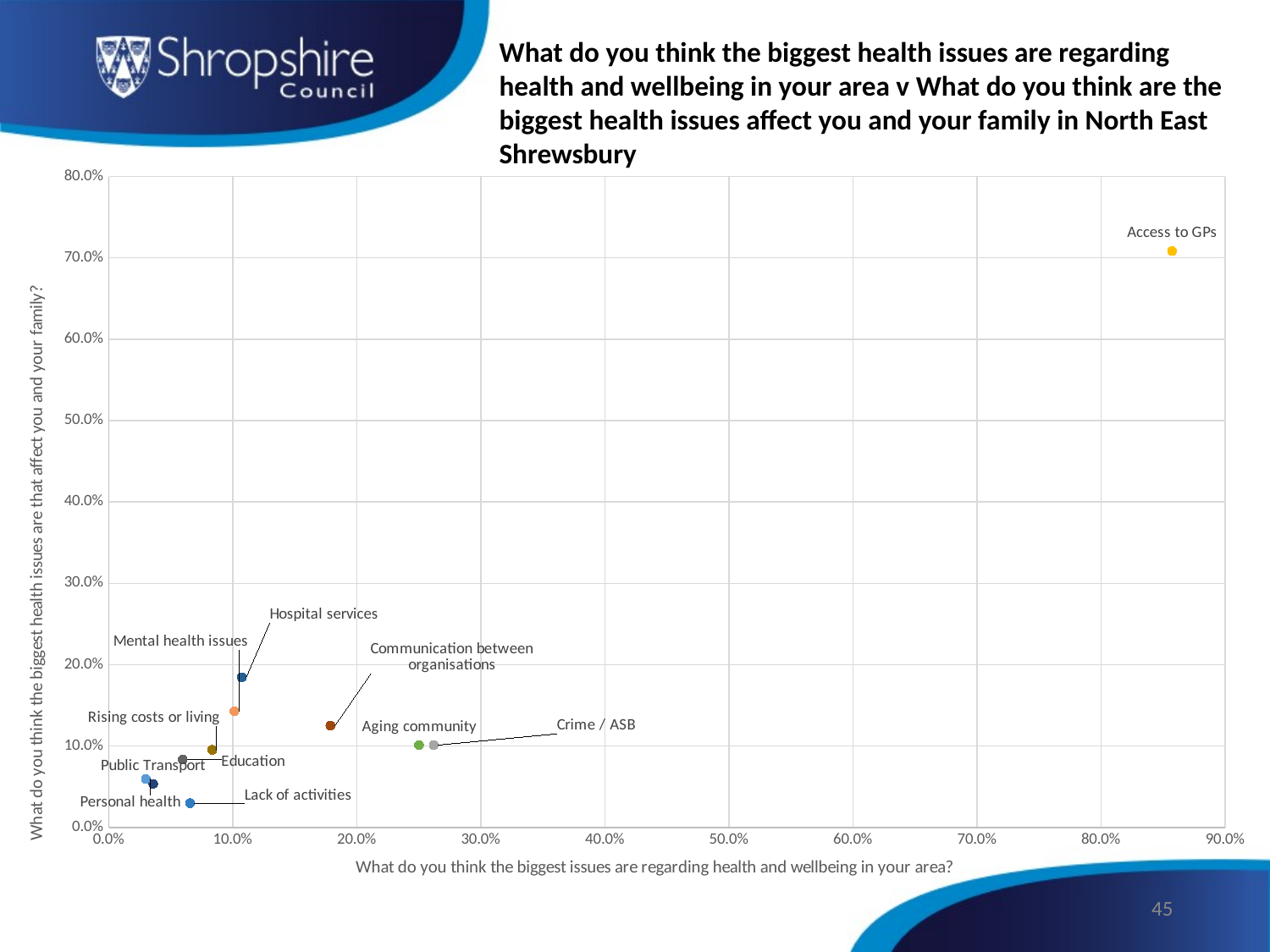
Is the horizontal-axis value for Access to GPs greater or less than 80%? greater What is the title of the horizontal axis? What do you think the biggest issues are regarding health and wellbeing in your area? What kind of chart is shown on the slide? scatter chart Which labelled point has the lowest value on the vertical axis? Personal health Is the horizontal-axis value for Aging community greater or less than 20%? greater Is the vertical-axis value for Access to GPs greater or less than 60%? greater How many labelled data points are plotted on the chart? 11 Which has the higher vertical-axis value, Access to GPs or Personal health? Access to GPs Which labelled point has the highest value on the horizontal axis (biggest issues in your area)? Access to GPs Which labelled point has the highest value on the vertical axis (issues affecting you and your family)? Access to GPs